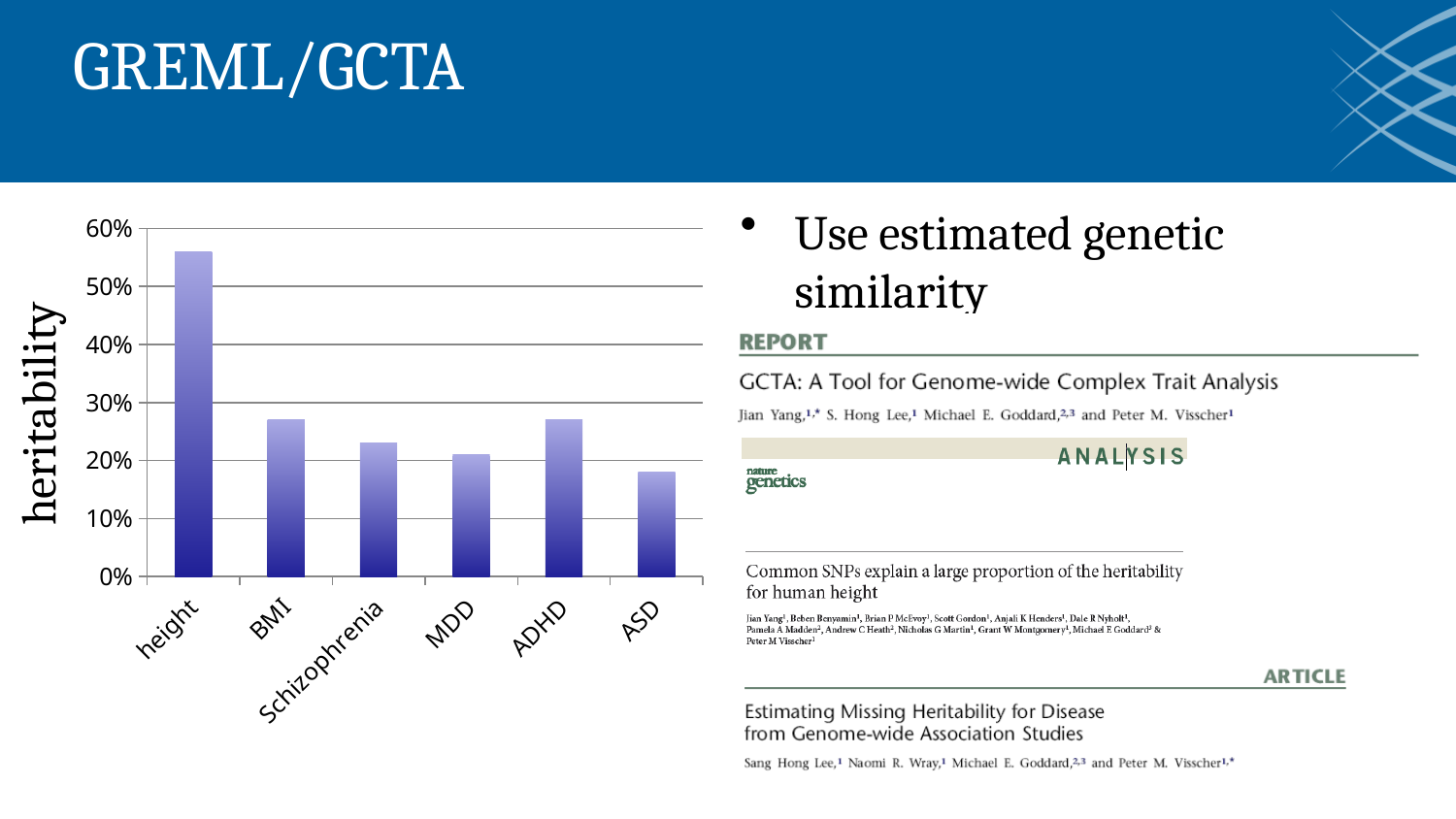
Is the heritability value for height greater or less than 50%? greater Is the heritability value for ADHD greater or less than 30%? less Which category has the highest heritability in the chart? height Is the heritability value for Schizophrenia greater or less than 30%? less Which has the larger heritability, height or BMI? height What kind of chart is shown on the slide? bar chart What is the label on the y axis of the chart? heritability Which has the larger heritability, ADHD or ASD? ADHD How many categories are shown on the x axis of the chart? 6 Which category has the lowest heritability in the chart? ASD